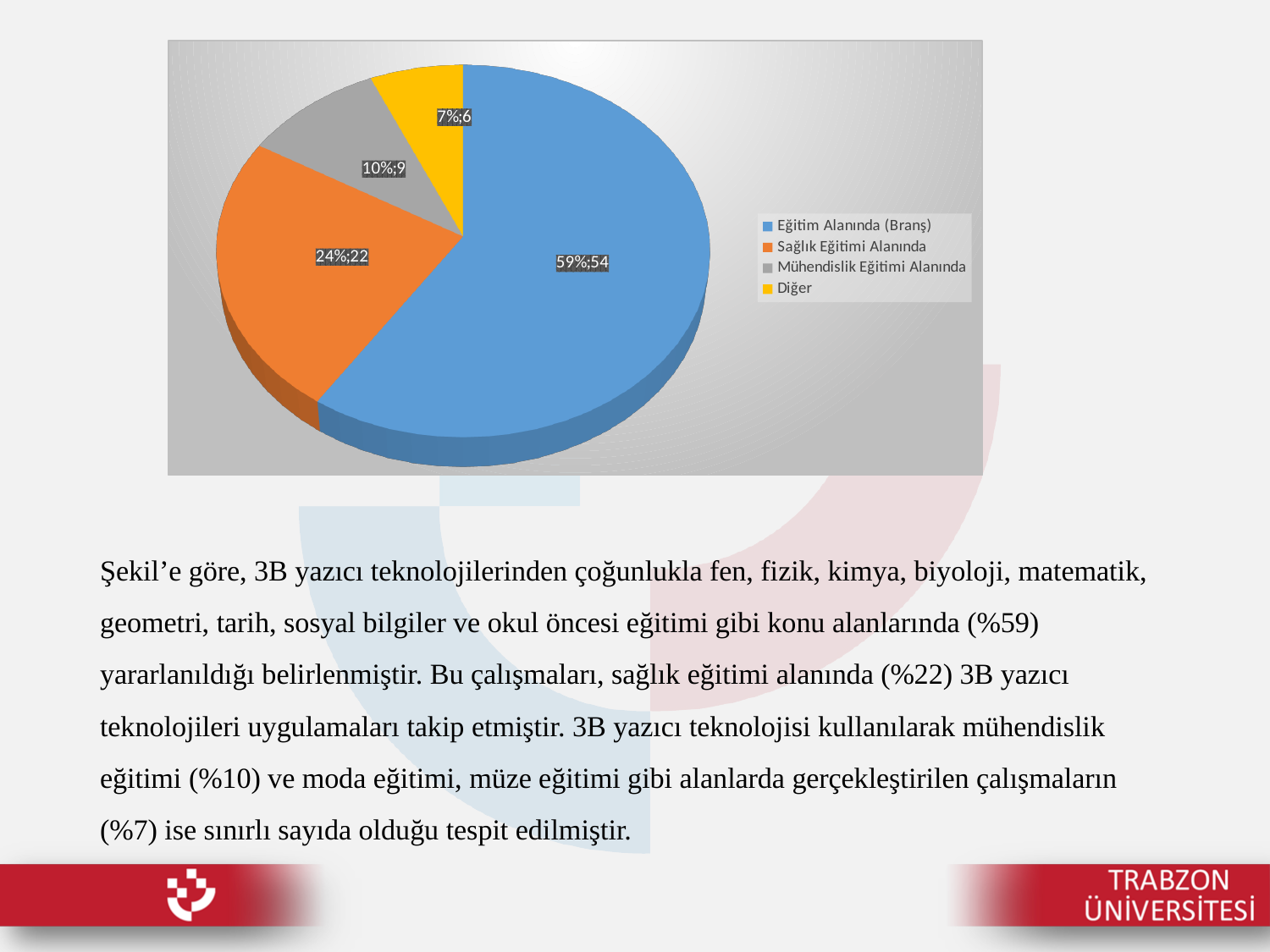
What is the difference between the counts for Eğitim Alanında (Branş) and Sağlık Eğitimi Alanında? 32 Which category has the smallest slice of the pie? Diğer What is the count shown for Sağlık Eğitimi Alanında? 22 What share of the pie does Eğitim Alanında (Branş) represent? 59% What share of the pie does Sağlık Eğitimi Alanında represent? 24% What is the count shown for Diğer? 6 How many slices does the pie chart have? 4 What is the count shown for Mühendislik Eğitimi Alanında? 9 How many entries does the legend of the pie chart list? 4 Which category has the largest slice of the pie? Eğitim Alanında (Branş) What is the count shown for Eğitim Alanında (Branş)? 54 What kind of chart is shown on the slide? pie chart